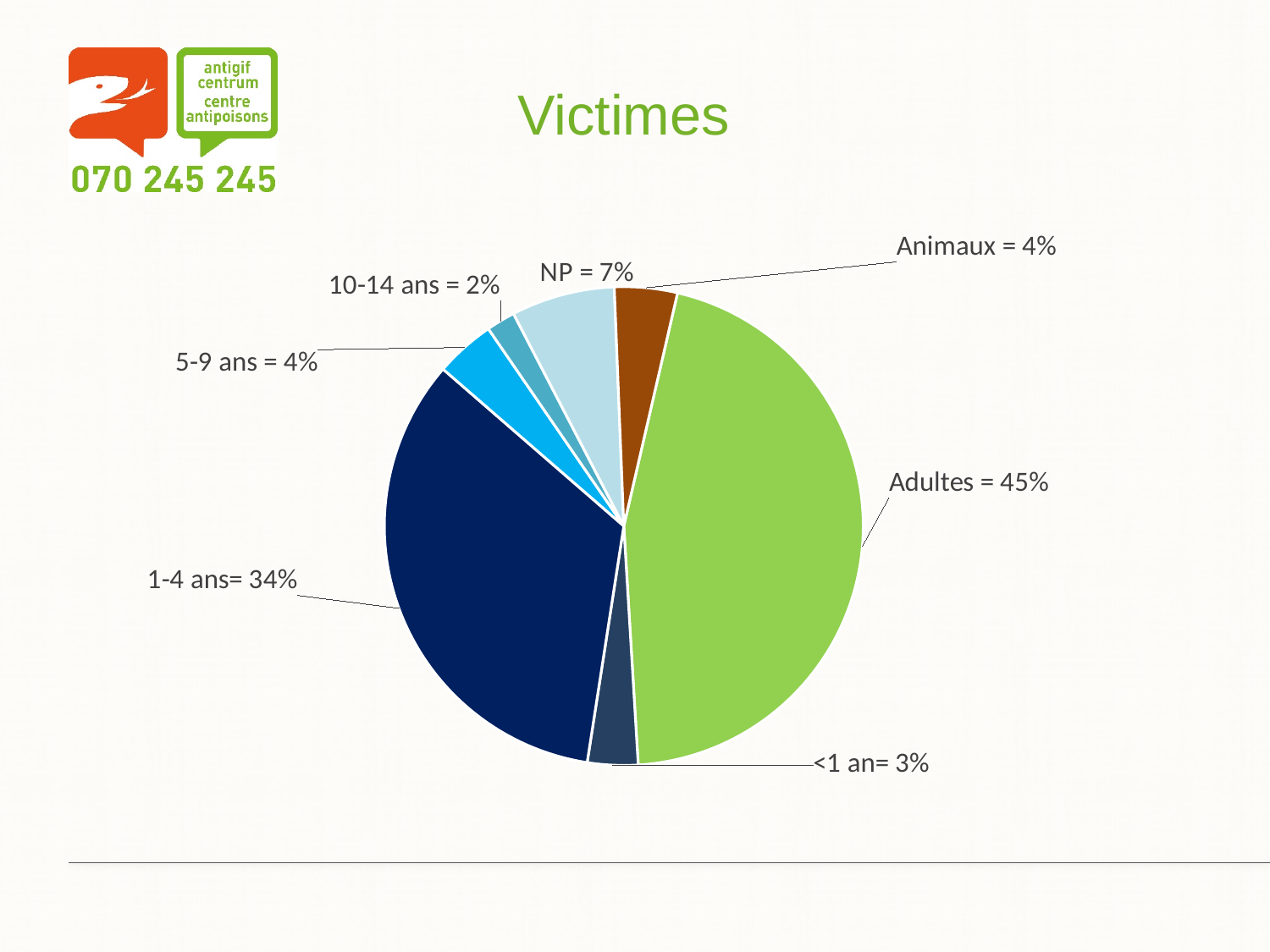
What kind of chart is shown on the slide? Pie chart Which category has the largest share of the pie? Adultes What share of victims are <1 an? 3% Which category has the smallest share of the pie? 10-14 ans Which is larger, the share for NP or the share for 5-9 ans? NP How many slices does the pie chart have? 7 What share of victims are NP? 7% What is the title of the chart? Victimes What colour is the Animaux slice? Brown What share of victims are Adultes? 45% What share of victims are 1-4 ans? 34% What is the difference between the Adultes share and the 1-4 ans share? 11%